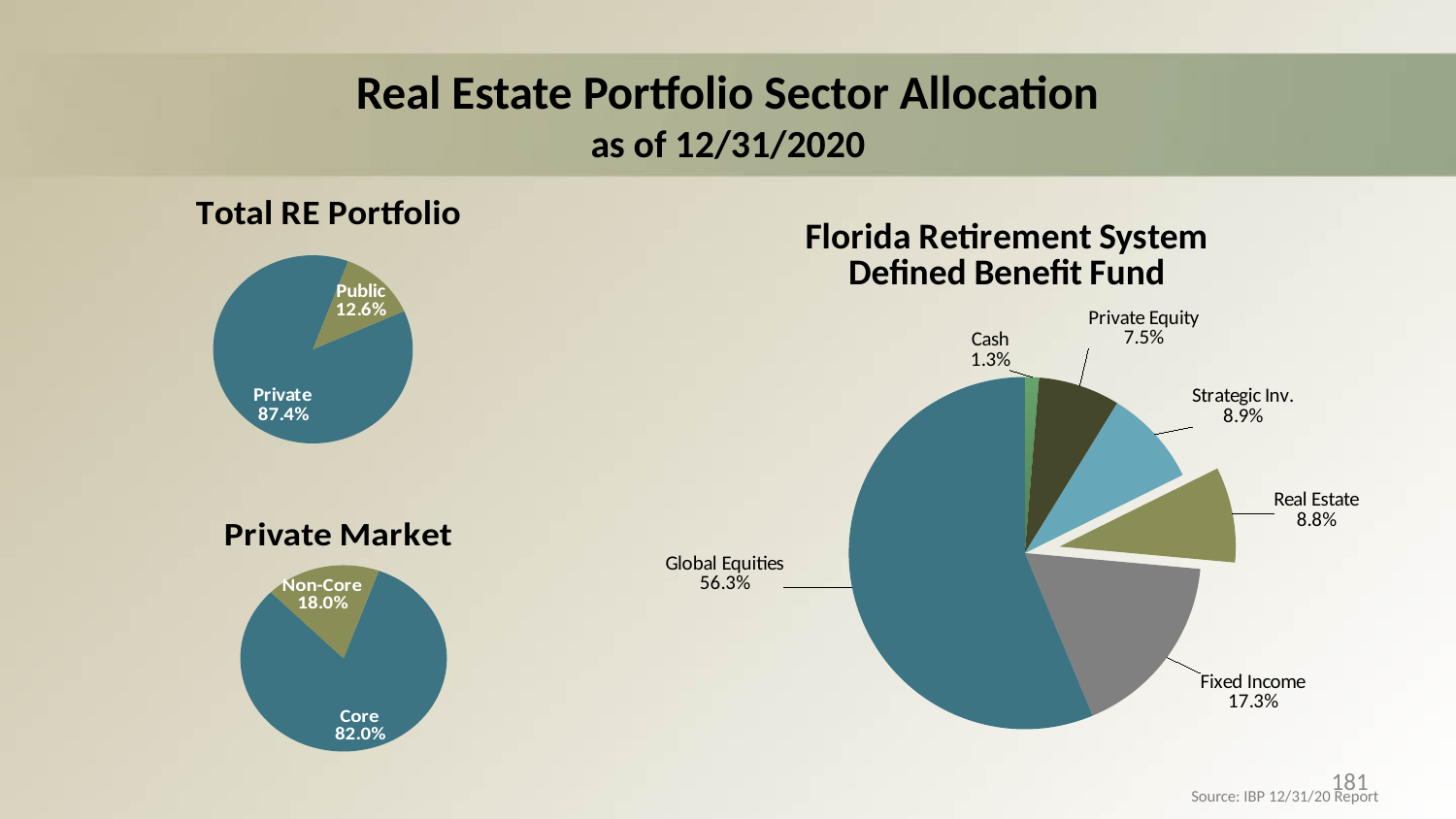
What type of chart is the Private Market chart? Pie chart In the Florida Retirement System Defined Benefit Fund chart, which category has the largest share? Global Equities In the Total RE Portfolio chart, what share is Public? 12.6% In the Private Market chart, what share is Non-Core? 18.0% In the Private Market chart, which slice is larger, Core or Non-Core? Core In the Florida Retirement System Defined Benefit Fund chart, which slice is pulled out from the pie? Real Estate In the Florida Retirement System Defined Benefit Fund chart, how many categories are shown? 6 In the Total RE Portfolio chart, what share is Private? 87.4% In the Florida Retirement System Defined Benefit Fund chart, what share is Strategic Inv.? 8.9% In the Florida Retirement System Defined Benefit Fund chart, what share is Fixed Income? 17.3% In the Florida Retirement System Defined Benefit Fund chart, which category has the smallest share? Cash In the Florida Retirement System Defined Benefit Fund chart, what is the difference between Global Equities and Fixed Income? 39.0%